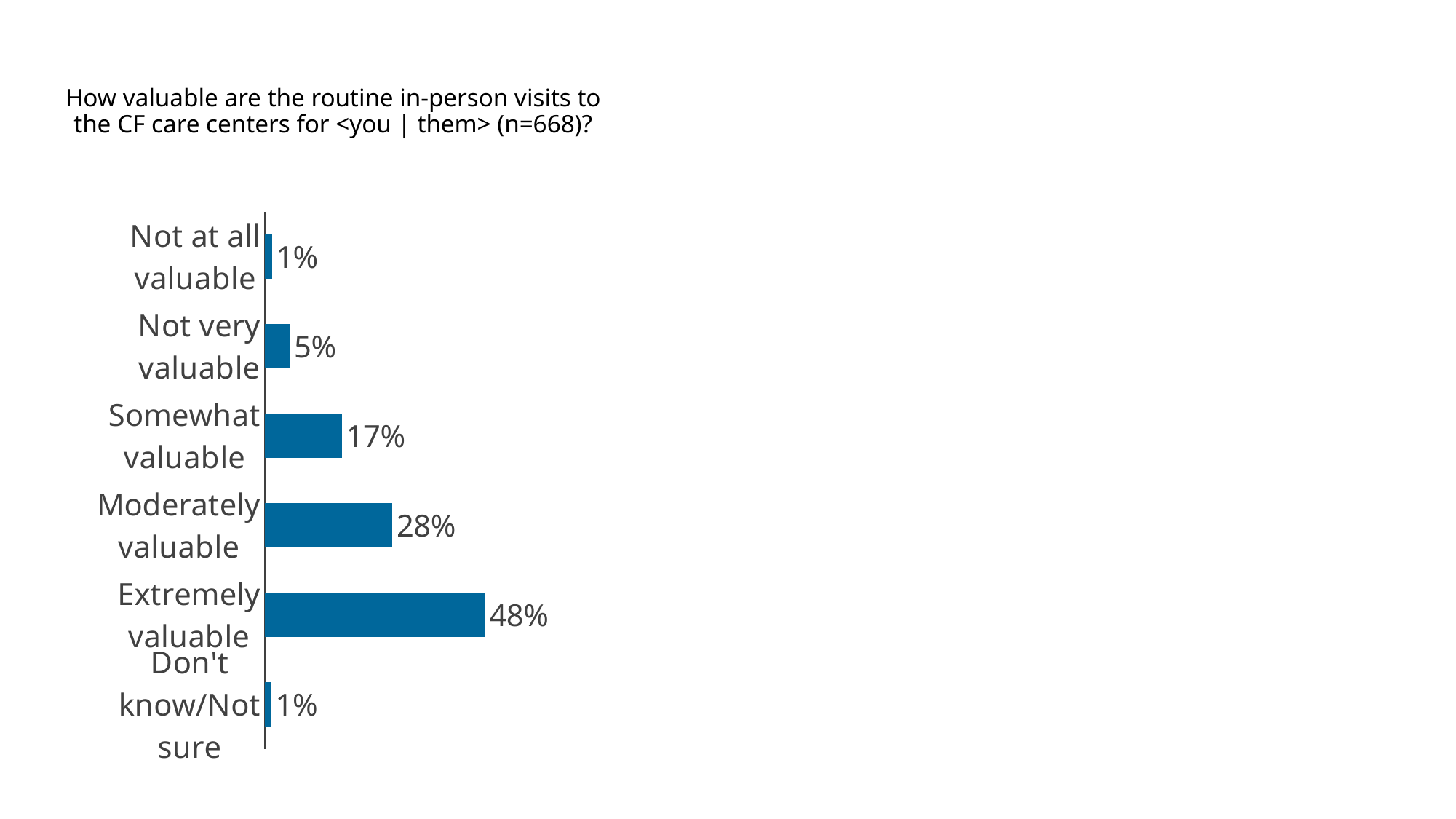
Which is larger, the percentage for 'Moderately valuable' or for 'Somewhat valuable'? Moderately valuable What is the difference in percentage points between 'Extremely valuable' and 'Moderately valuable'? 20 What is the difference in percentage points between 'Somewhat valuable' and 'Not very valuable'? 12 What is the sample size (n) stated in the chart title? 668 What type of chart is shown on the slide? Bar chart What percentage of respondents said routine in-person visits are not very valuable? 5% What percentage of respondents answered 'Don't know/Not sure'? 1% What percentage of respondents said routine in-person visits are extremely valuable? 48% What percentage of respondents said routine in-person visits are somewhat valuable? 17% How many response categories are shown in the chart? 6 What percentage of respondents said routine in-person visits are moderately valuable? 28% Which response category has the highest percentage? Extremely valuable